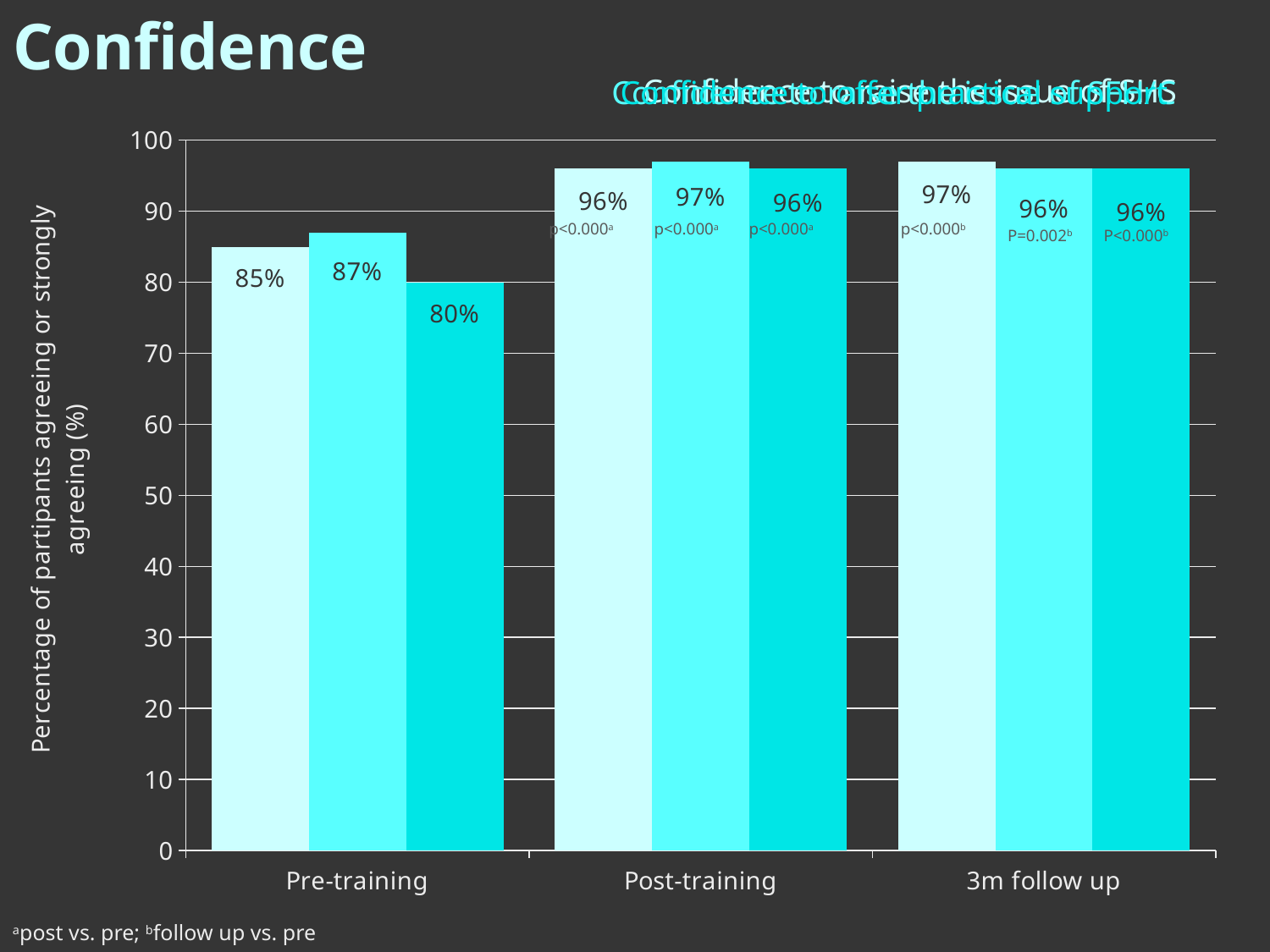
What is the value of the darkest (third) bar in the Pre-training group? 80% How many categories are shown on the x axis? 3 What kind of chart is shown on the slide? Bar chart What is the difference between the middle bar in Post-training and the middle bar in Pre-training? 10 percentage points In the Pre-training group, which is larger: the lightest bar or the darkest bar? The lightest bar (85%) Is the value of the darkest bar in the Pre-training group greater or less than 90? less How many bars are plotted for each category? 3 What is the value of the lightest (first) bar in the Pre-training group? 85% What is the value of the middle bar in the Post-training group? 97% What is the value of the lightest (first) bar in the 3m follow up group? 97% Do the values rise or fall from Pre-training to Post-training? Rise Which bar has the lowest value on the chart? The darkest bar in Pre-training (80%)